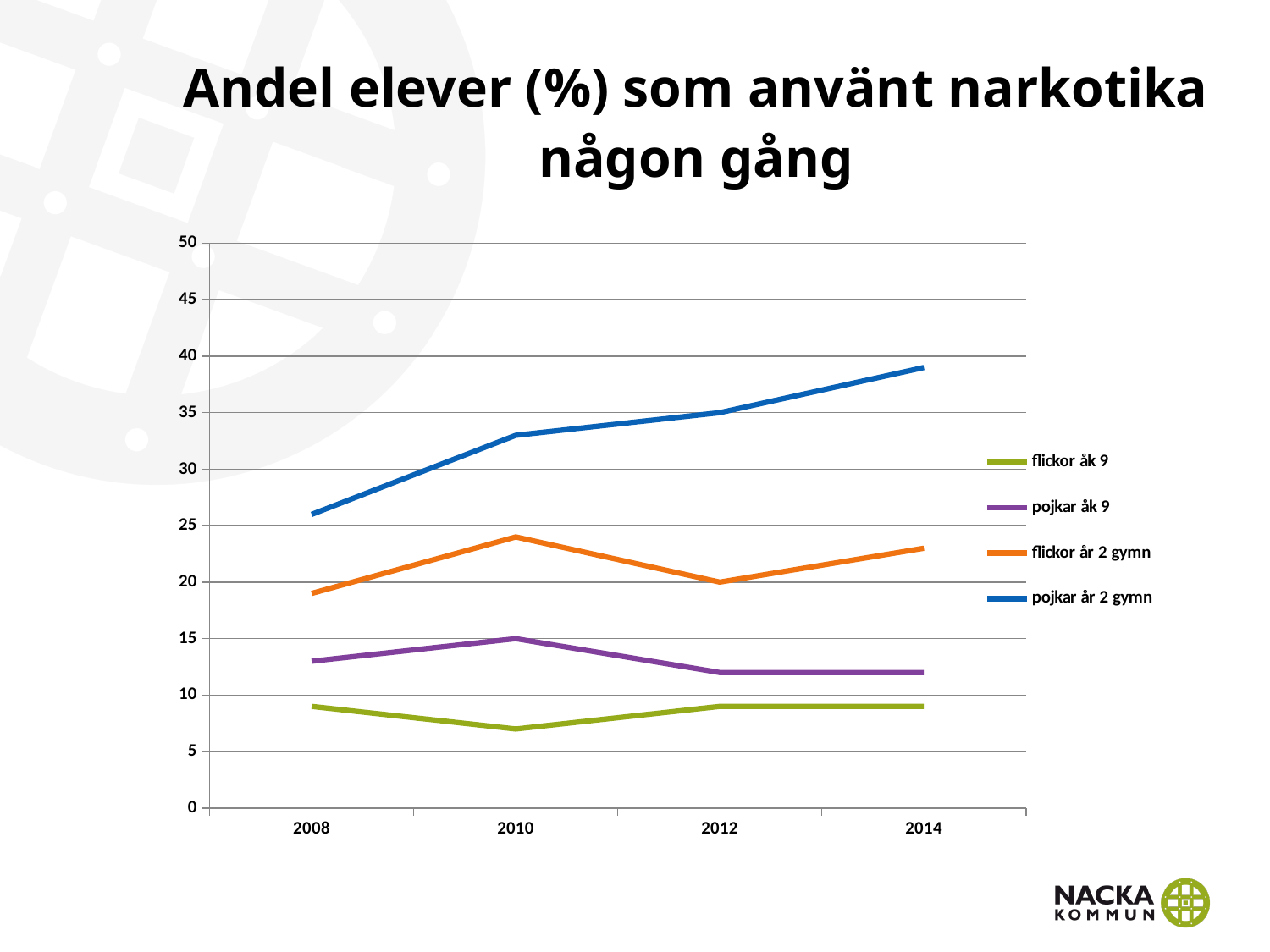
What is the value for pojkar åk 9 in 2010? 15 What is the value for pojkar år 2 gymn in 2012? 35 How many years are shown on the x axis? 4 What kind of chart is shown on the slide? line chart Which series has the highest values across all years? pojkar år 2 gymn What is the value for flickor år 2 gymn in 2012? 20 Is the value for flickor åk 9 in 2010 greater or less than 10? less How many series does the legend list? 4 Does the line for pojkar år 2 gymn rise or fall from 2008 to 2014? rise Which is larger in 2010: flickor år 2 gymn or pojkar åk 9? flickor år 2 gymn Is the value for pojkar år 2 gymn in 2014 greater or less than 35? greater Which series has the lowest values across all years? flickor åk 9